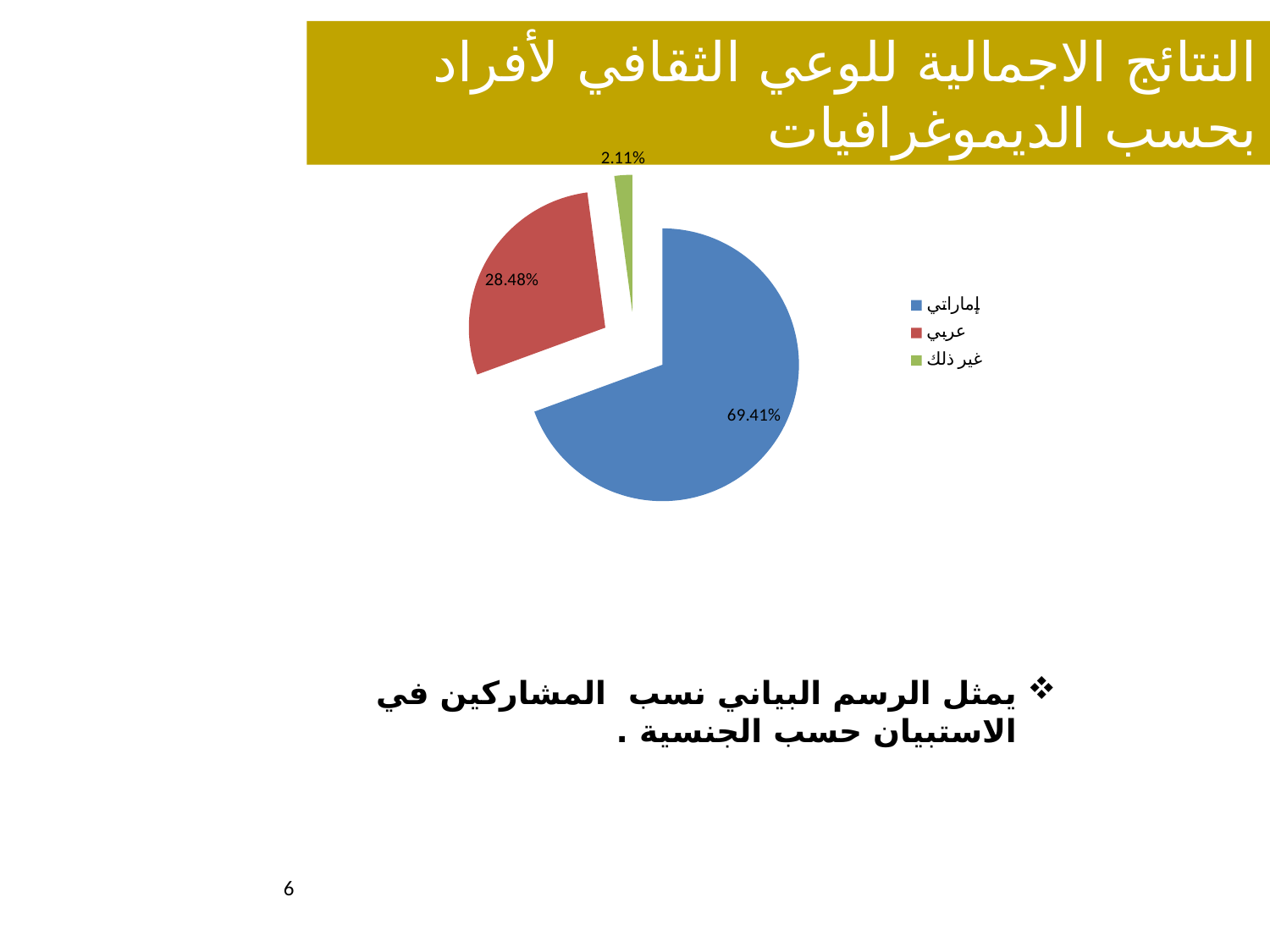
How many slices does the pie chart have? 3 Which category has the smallest slice of the pie? غير ذلك What share of the pie does the عربي slice represent? 28.48% What share of the pie does the إماراتي slice represent? 69.41% What share of the pie does the غير ذلك slice represent? 2.11% What colour is the slice for عربي? red What colour is the slice for إماراتي? blue What kind of chart is shown on the slide? pie chart Which is larger, the share for عربي or the share for غير ذلك? عربي How many entries does the legend list? 3 What is the difference in percentage points between the إماراتي slice and the عربي slice? 40.93 Which category has the largest slice of the pie? إماراتي